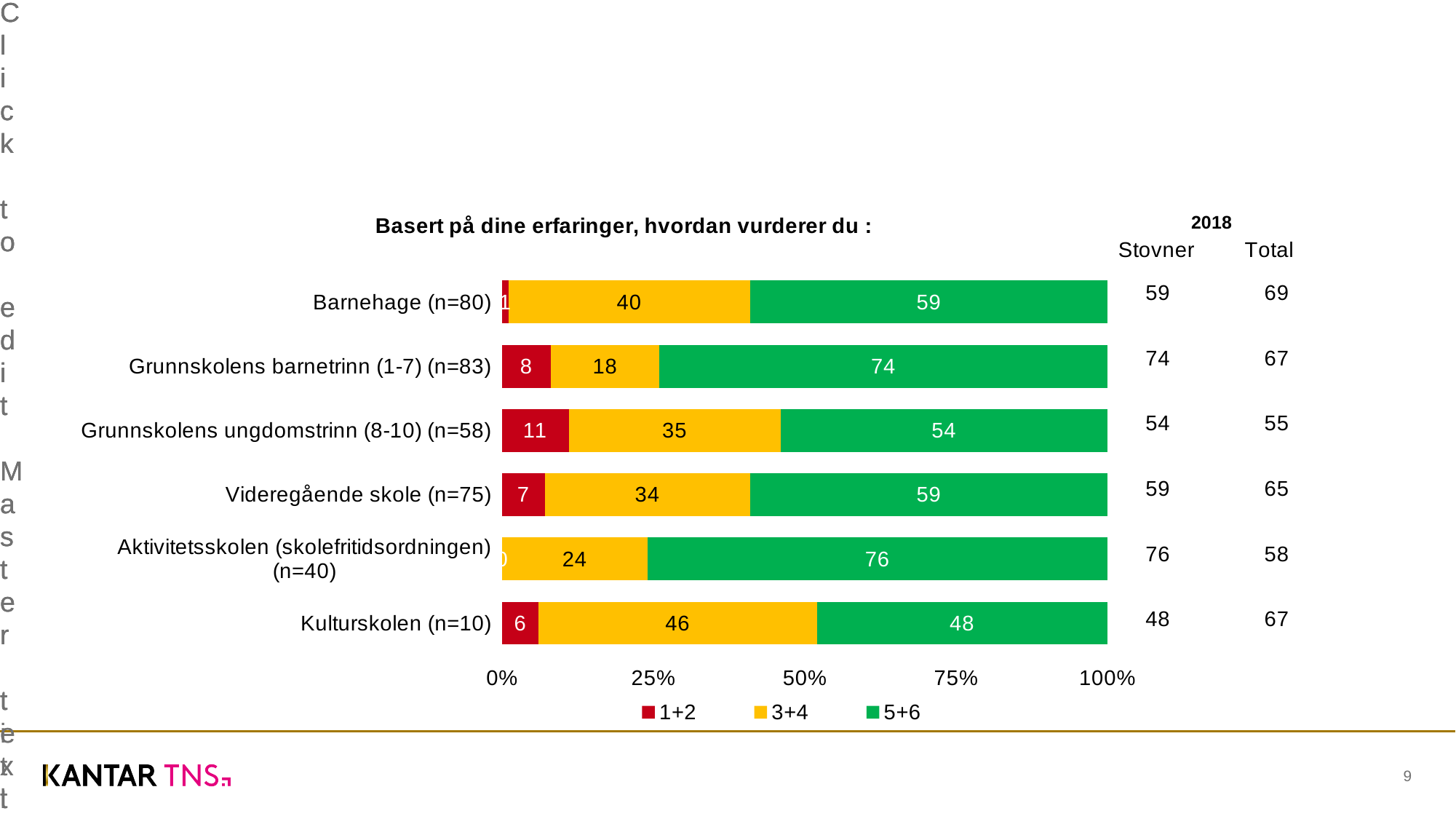
How many series does the legend list? 3 What kind of chart is shown on the slide? Stacked bar chart What is the value of the 1+2 series for Grunnskolens ungdomstrinn (8-10) (n=58)? 11 What is the title of the chart? Basert på dine erfaringer, hvordan vurderer du : Which has the larger 3+4 value, Barnehage (n=80) or Videregående skole (n=75)? Barnehage (n=80) How many categories are shown in the chart? 6 Which category has the highest value for the 5+6 series? Aktivitetsskolen (skolefritidsordningen) (n=40) What is the difference between the 5+6 values for Barnehage (n=80) and Kulturskolen (n=10)? 11 Which category has the lowest value for the 5+6 series? Kulturskolen (n=10) What is the value of the 3+4 series for Kulturskolen (n=10)? 46 What is the value of the 5+6 series for Grunnskolens barnetrinn (1-7) (n=83)? 74 Which category has the highest value for the 1+2 series? Grunnskolens ungdomstrinn (8-10) (n=58)